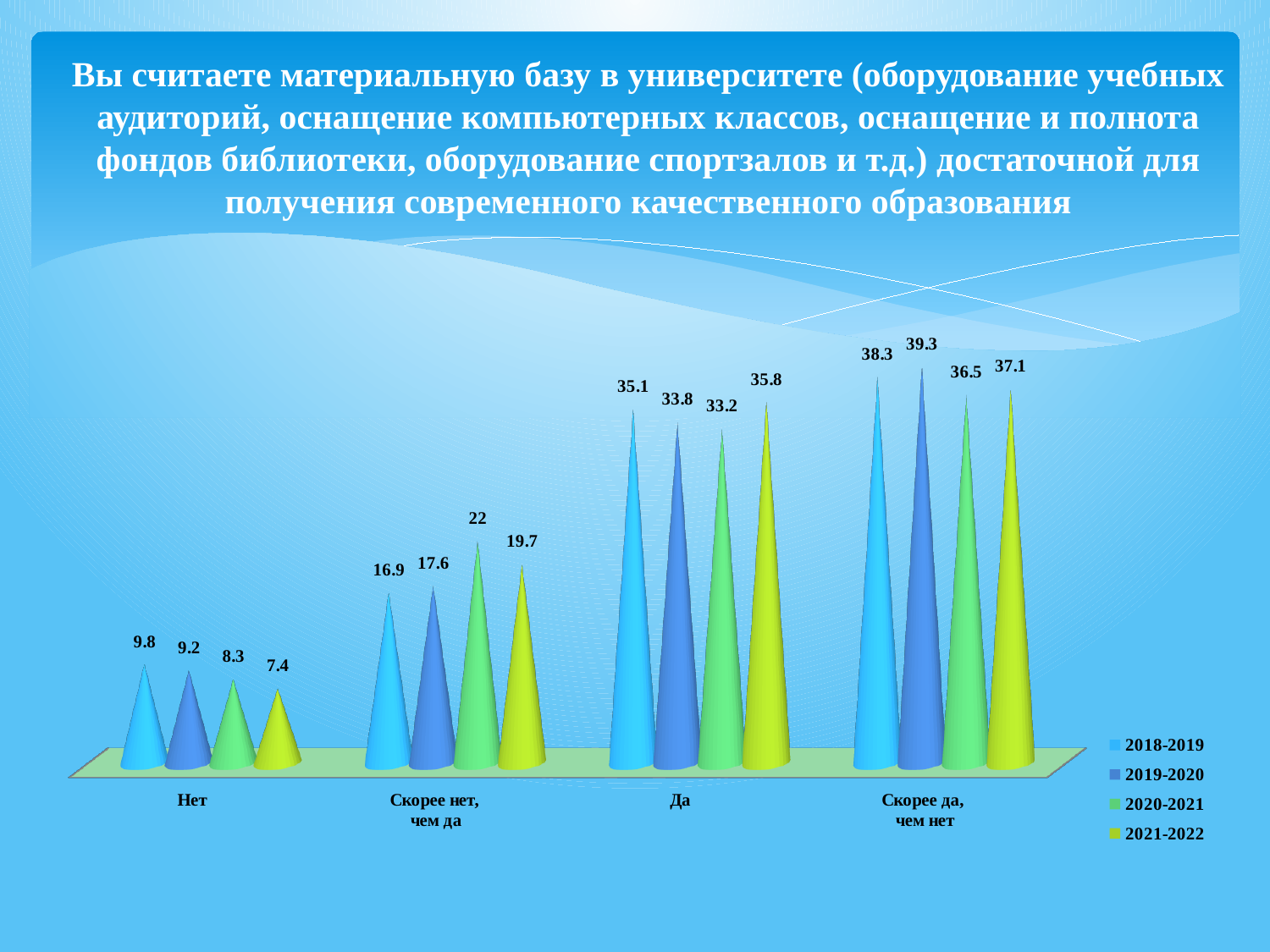
Which category has the highest value in the 2019-2020 series? Скорее да, чем нет Which is larger for "Скорее нет, чем да": the 2020-2021 value or the 2021-2022 value? 2020-2021 What is the difference between the 2018-2019 and 2021-2022 values for "Нет"? 2.4 Which category has the lowest value in the 2021-2022 series? Нет What kind of chart is shown on the slide? Bar chart How many categories are shown on the x axis? 4 What is the value for "Скорее нет, чем да" in the 2020-2021 series? 22 What is the value for "Скорее да, чем нет" in the 2019-2020 series? 39.3 Which series is shown in yellow-green in the legend? 2021-2022 How many series does the legend list? 4 What is the value for "Нет" in the 2018-2019 series? 9.8 What is the value for "Да" in the 2021-2022 series? 35.8